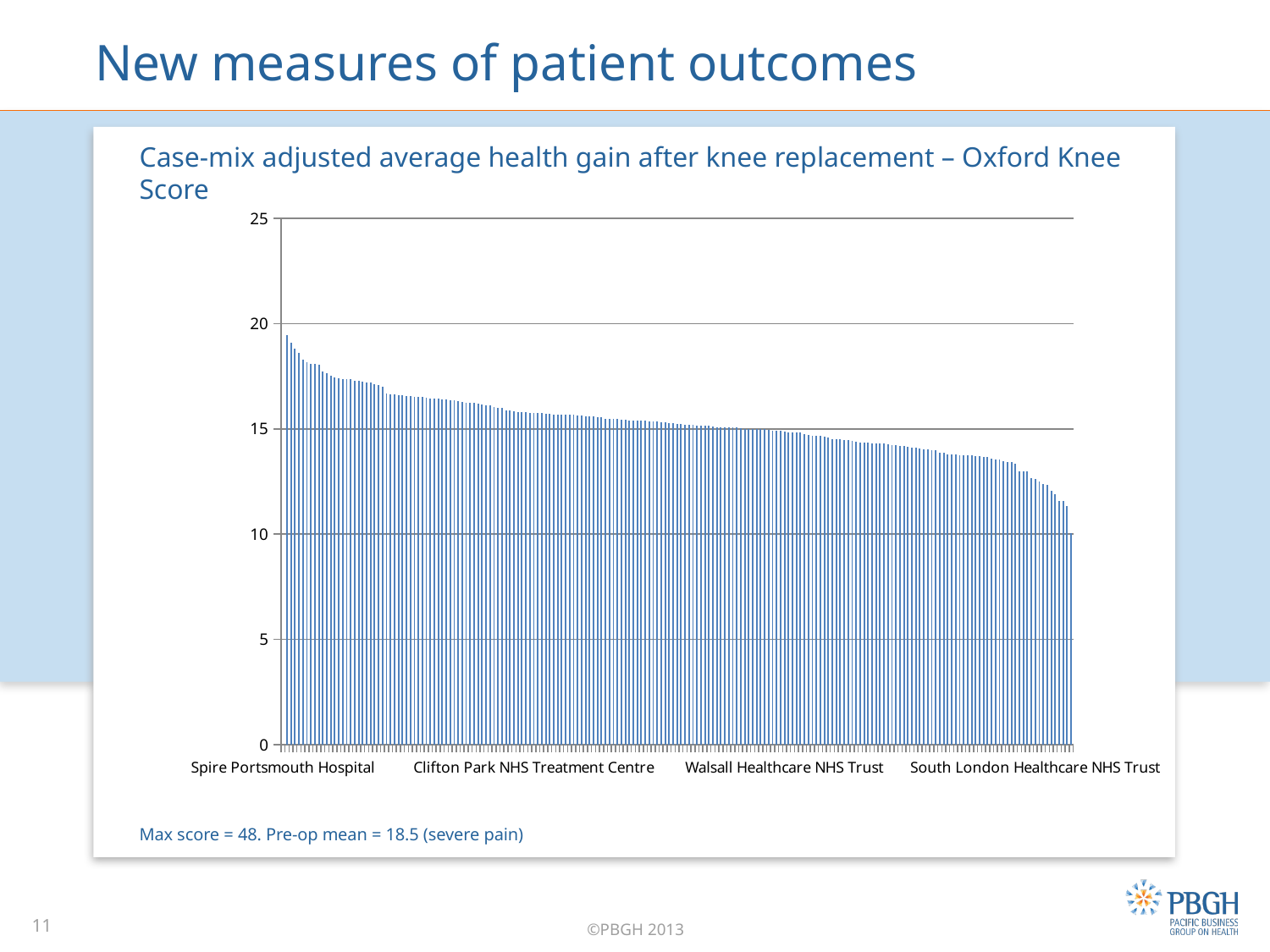
Is the tallest bar in the chart greater or less than 20? less Is the value for Clifton Park NHS Treatment Centre greater or less than 20? less Do the bar values rise or fall from left to right along the x axis? fall Is the value for South London Healthcare NHS Trust greater or less than 15? less What kind of chart is shown on the slide? bar chart Which of the labelled providers has the highest value: Spire Portsmouth Hospital or South London Healthcare NHS Trust? Spire Portsmouth Hospital What is the maximum value shown on the y axis? 25 Of the four providers labelled on the x axis, which has the lowest value? South London Healthcare NHS Trust What is the title of the chart? Case-mix adjusted average health gain after knee replacement – Oxford Knee Score Of the four providers labelled on the x axis, which has the highest value? Spire Portsmouth Hospital